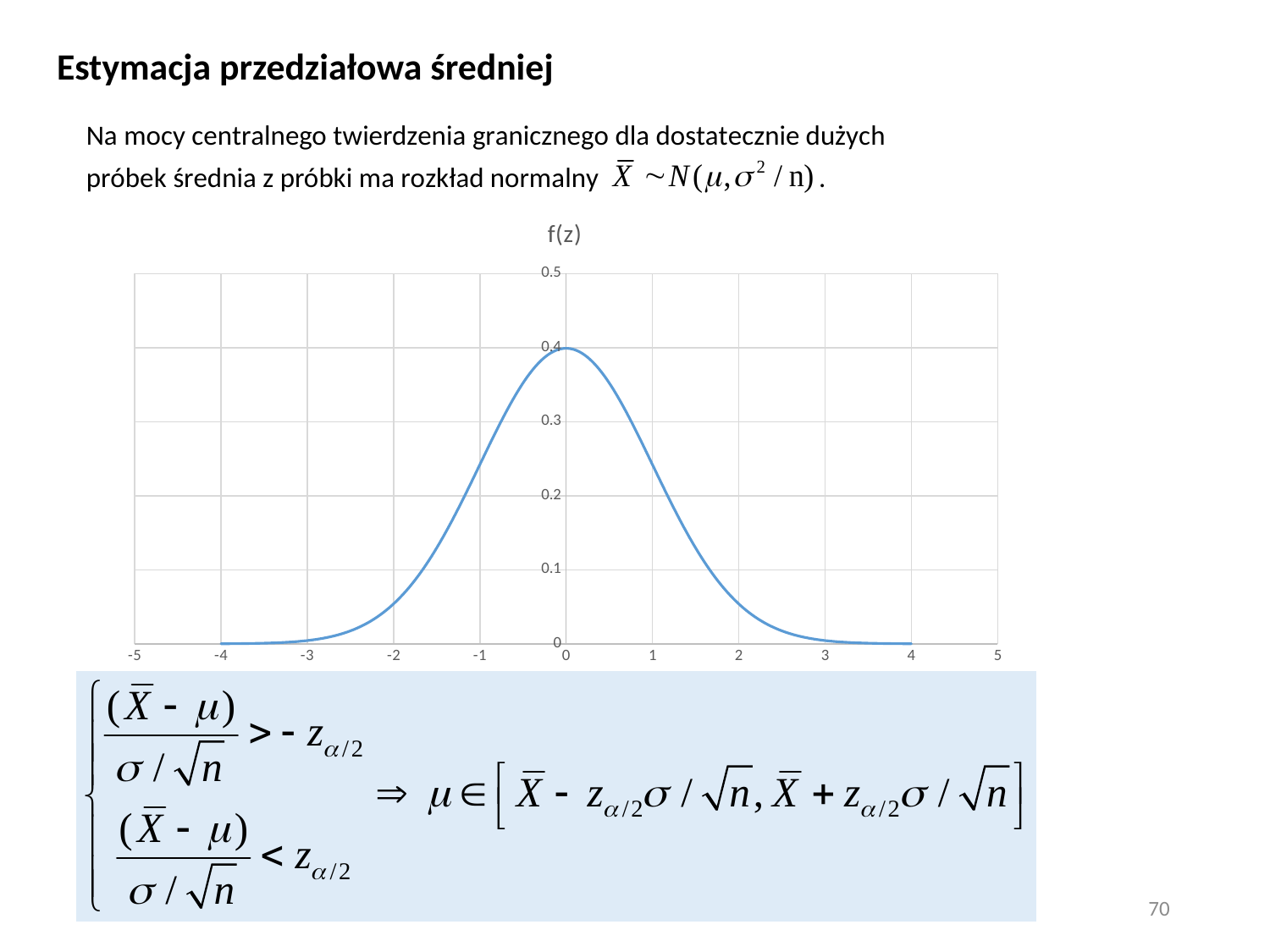
Is the value of the curve at z = 0 greater or less than 0.3? greater What kind of chart is shown on the slide? line chart At which value of z does the curve reach its highest point? 0 Which is larger, the value of the curve at z = -1 or at z = -3? z = -1 Which is larger, the value of the curve at z = 0 or at z = 2? z = 0 Is the value of the curve at z = -1 greater or less than 0.3? less Is the value of the curve at z = 1 greater or less than 0.2? greater Does the curve rise or fall as z goes from -4 to 0? rise What is the highest tick value shown on the vertical axis? 0.5 Does the curve rise or fall as z goes from 0 to 4? fall What is the title of the chart? f(z)